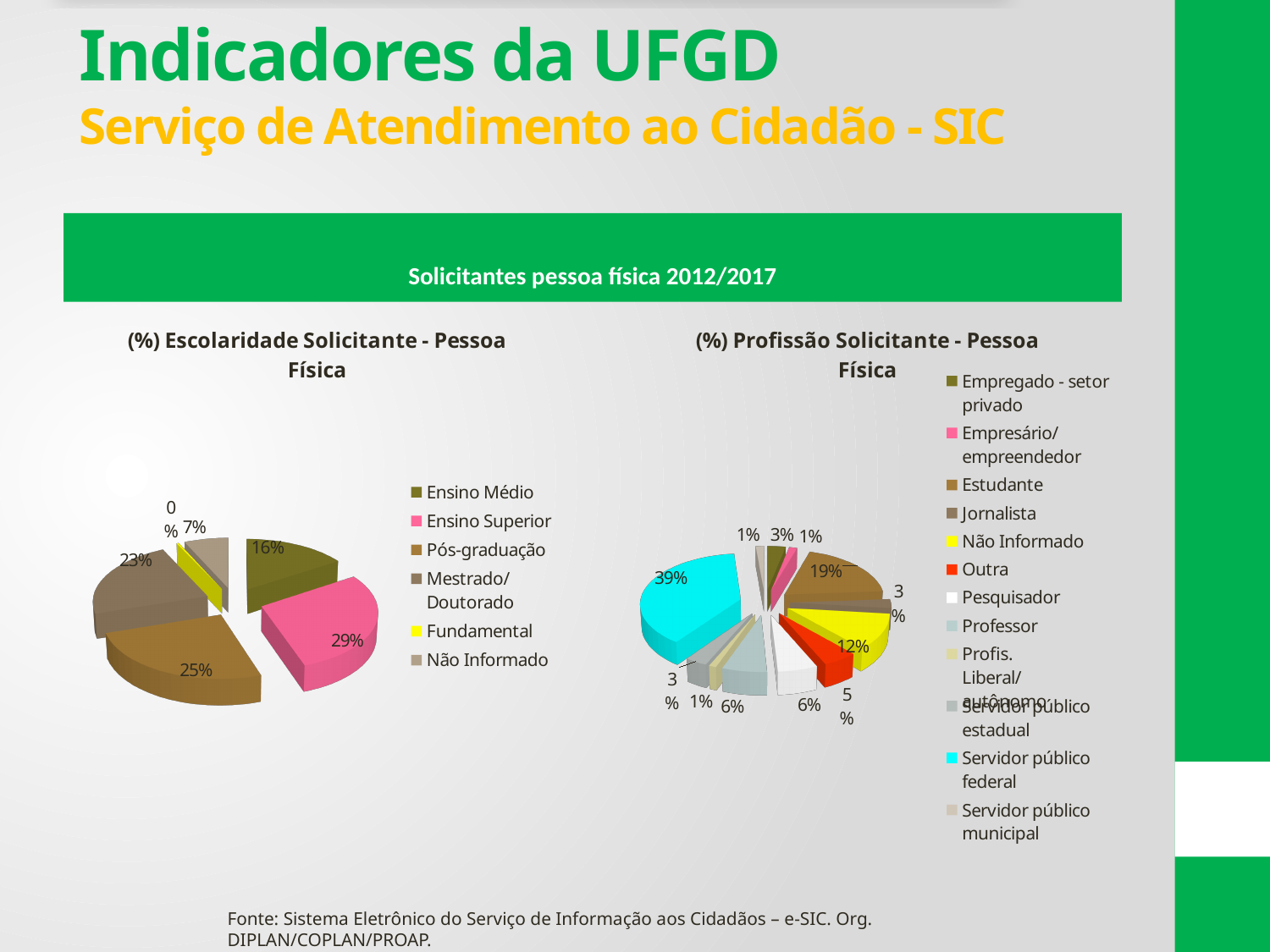
In the "(%) Profissão Solicitante - Pessoa Física" chart, what is the value for Não Informado? 12% How many categories does the legend of the "(%) Escolaridade Solicitante - Pessoa Física" chart list? 6 What type of chart is the "(%) Escolaridade Solicitante - Pessoa Física" chart? Pie chart In the "(%) Escolaridade Solicitante - Pessoa Física" chart, what is the value for Mestrado/Doutorado? 23% In the "(%) Profissão Solicitante - Pessoa Física" chart, which category has the largest share? Servidor público federal In the "(%) Escolaridade Solicitante - Pessoa Física" chart, which category has the largest share? Ensino Superior In the "(%) Profissão Solicitante - Pessoa Física" chart, what is the value for Servidor público federal? 39% In the "(%) Escolaridade Solicitante - Pessoa Física" chart, what is the difference between Ensino Superior and Pós-graduação? 4 percentage points In the "(%) Escolaridade Solicitante - Pessoa Física" chart, what is the value for Ensino Superior? 29% In the "(%) Profissão Solicitante - Pessoa Física" chart, what is the value for Estudante? 19% In the "(%) Profissão Solicitante - Pessoa Física" chart, which is larger: Estudante or Outra? Estudante How many categories does the legend of the "(%) Profissão Solicitante - Pessoa Física" chart list? 12